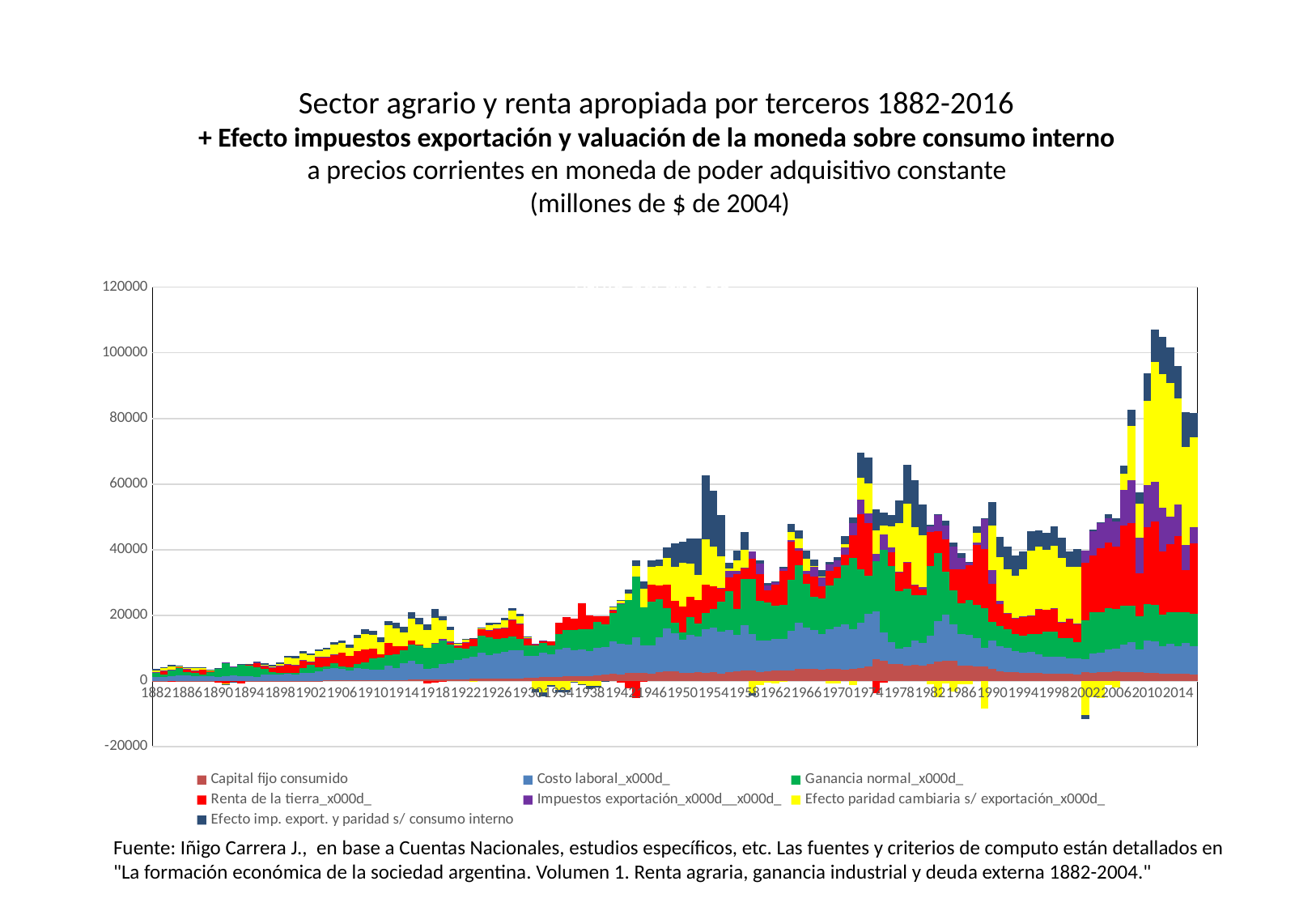
Overall, do the stacked bar totals rise or fall from 1882 to 2016? rise How many series does the legend list? 7 Is the stacked bar total for 2014 greater or less than 60000? greater Is the stacked bar total for 1882 greater or less than 20000? less Which period has the taller stacked bars: around 1890 or around 2010? around 2010 What kind of chart is shown on the slide? Stacked bar chart Is the stacked bar total for 1930 greater or less than 40000? less What is the first year shown on the x axis of the chart? 1882 What is the highest value shown on the y axis of the chart? 120000